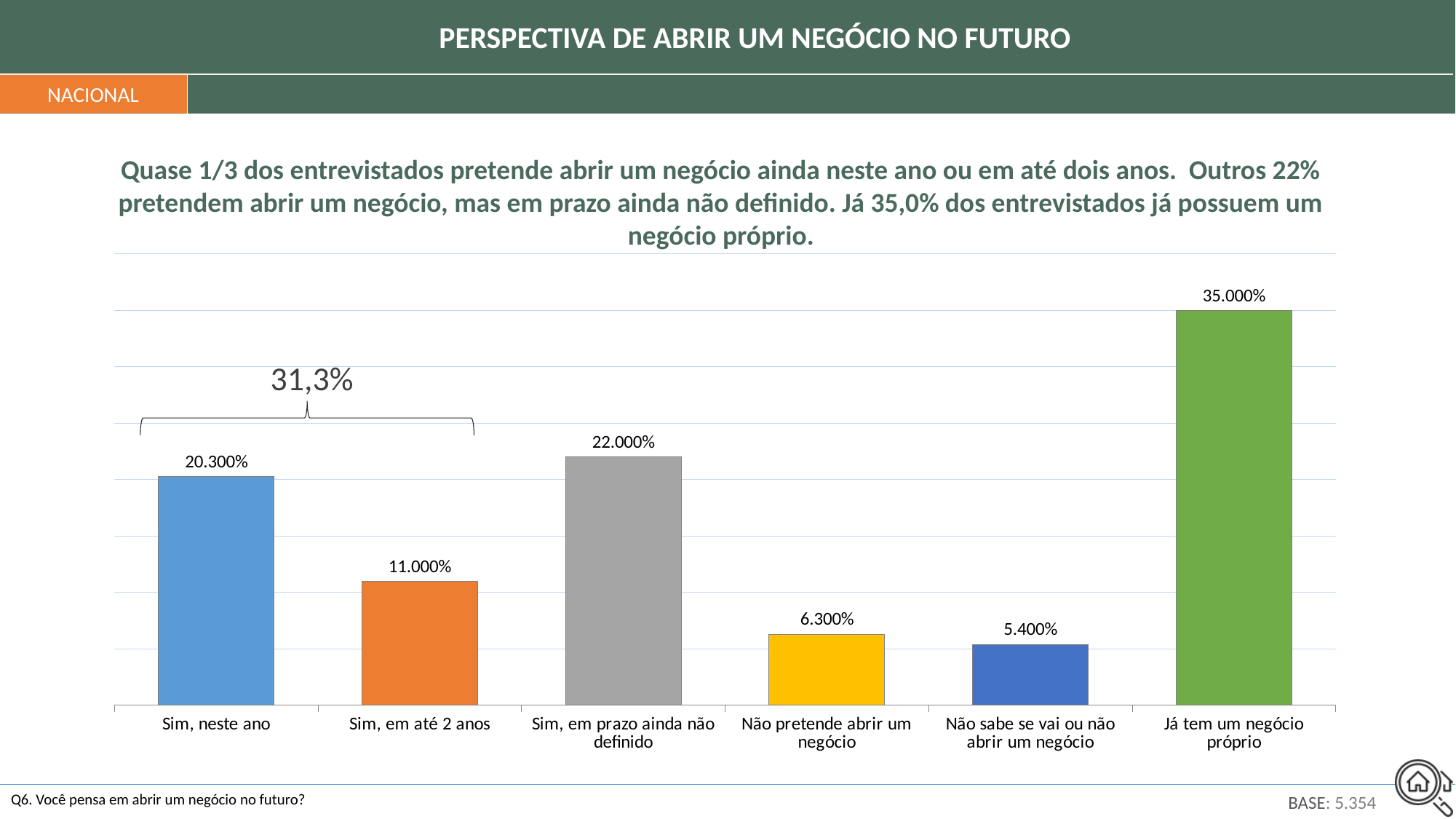
What is the value for "Sim, em até 2 anos"? 11.000% Which is larger, "Sim, neste ano" or "Sim, em até 2 anos"? Sim, neste ano What is the base (number of respondents) shown at the bottom of the slide? 5.354 What combined value does the bracket above the first two bars show? 31,3% Which category has the lowest value? Não sabe se vai ou não abrir um negócio What is the value for "Sim, neste ano"? 20.300% Which category has the highest value? Já tem um negócio próprio How many categories are shown on the x axis? 6 What is the value for "Não sabe se vai ou não abrir um negócio"? 5.400% What is the difference between "Já tem um negócio próprio" and "Sim, em prazo ainda não definido"? 13.000% What kind of chart is shown on the slide? Bar chart What is the value for "Sim, em prazo ainda não definido"? 22.000%